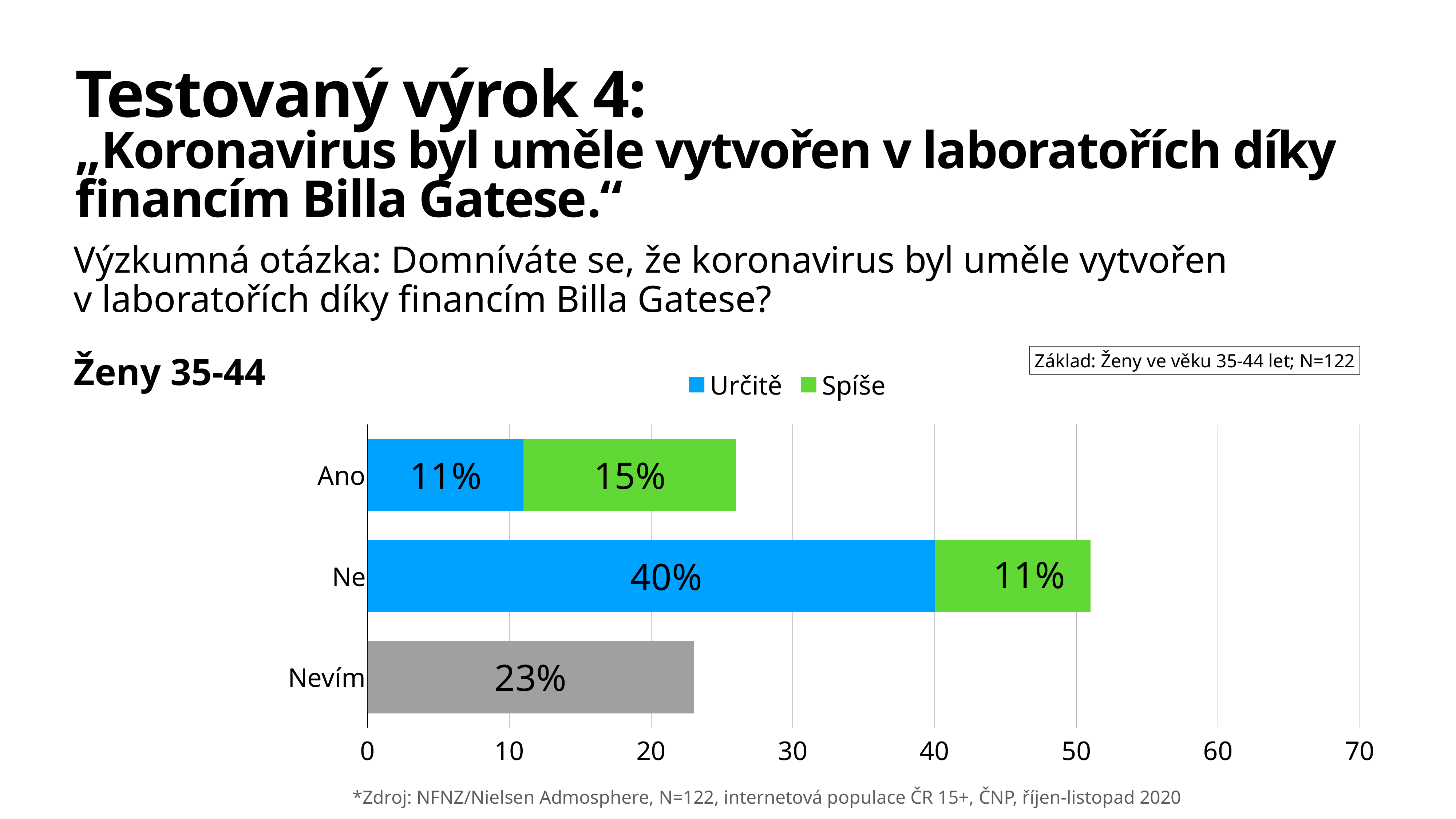
Which is larger: the 'Spíše' value for 'Ano' or the 'Spíše' value for 'Ne'? Ano What is the 'Určitě' value for the 'Ano' category? 11% How many series does the legend list? 2 What is the value shown for the 'Nevím' category? 23% What kind of chart is shown on the slide? Bar chart Which category has the highest 'Určitě' value? Ne What is the 'Spíše' value for the 'Ne' category? 11% What is the total of the stacked bar for 'Ne'? 51% How many categories are shown on the y axis of the chart? 3 What is the total of the stacked bar for 'Ano'? 26% What is the 'Určitě' value for the 'Ne' category? 40% What is the difference between the 'Určitě' values for 'Ne' and 'Ano'? 29%